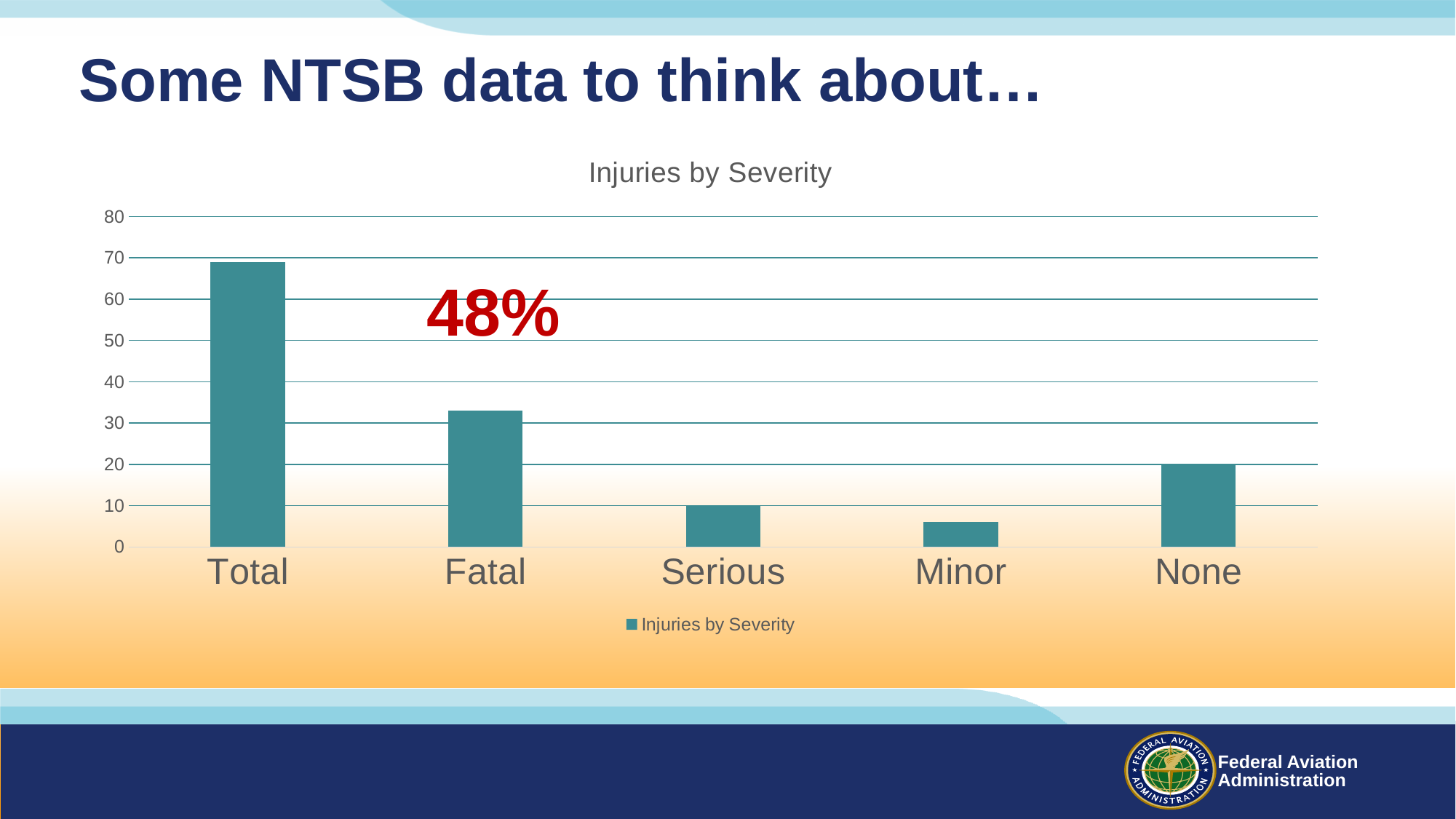
Which category has the lowest bar in the chart? Minor Is the value for Serious greater or less than 20? less Is the value for Fatal greater or less than 40? less How many series does the chart's legend list? 1 Is the value for Total greater or less than 60? greater What percentage is written in red text above the Fatal bar? 48% How many categories are shown on the x axis of the chart? 5 What kind of chart is shown on the slide? bar chart What is the title of the chart? Injuries by Severity Which category has the highest bar in the chart? Total Which is larger, the value for Fatal or the value for None? Fatal